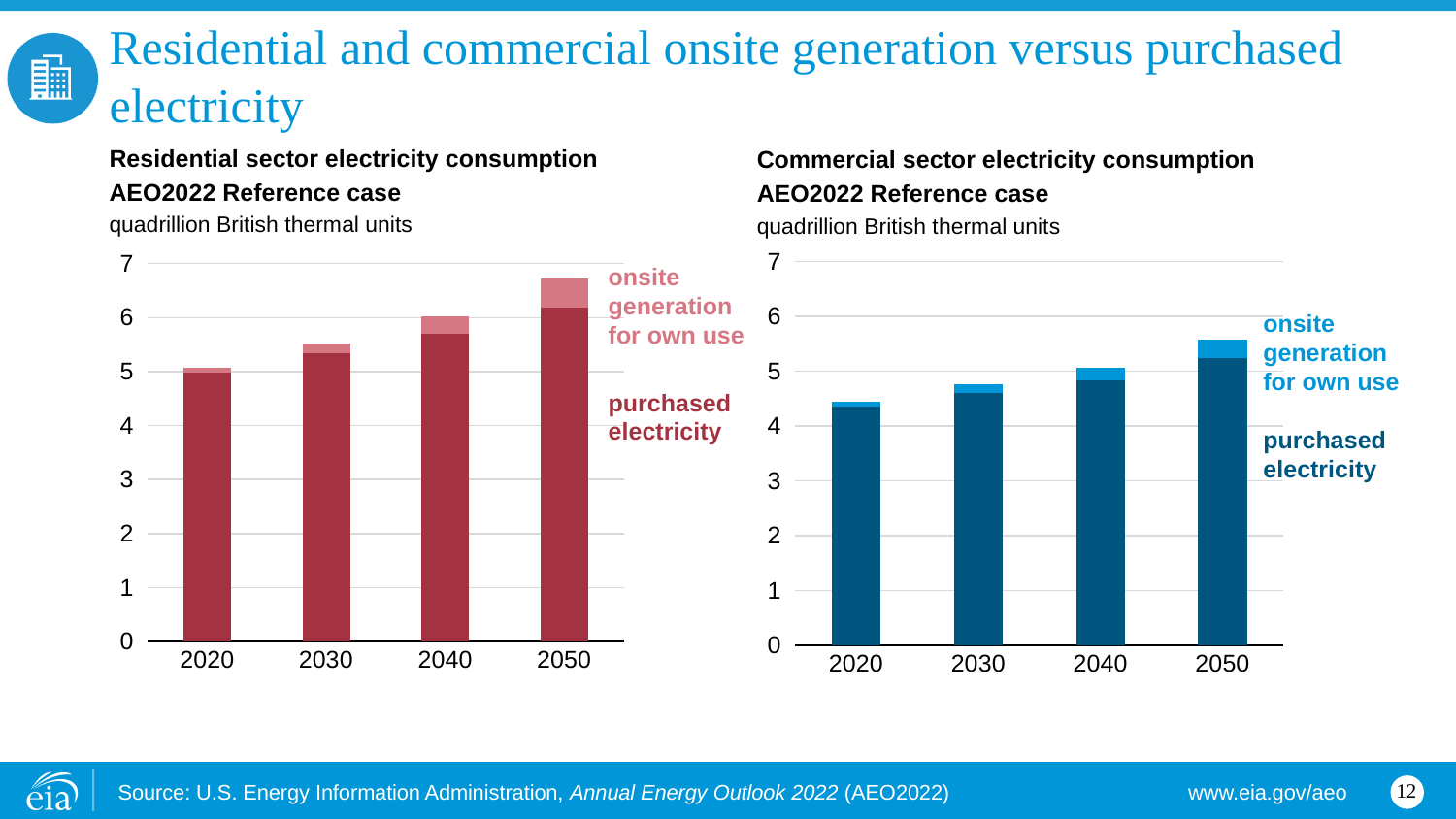
What unit is used on the y axis of the Residential sector electricity consumption chart? quadrillion British thermal units In the Residential sector electricity consumption chart, is the total value for 2050 greater or less than 6? greater How many series are labelled in the Residential sector electricity consumption chart? 2 In the Commercial sector electricity consumption chart, do the total bars rise or fall from 2020 to 2050? rise In the Commercial sector electricity consumption chart, which year has the lowest total bar? 2020 In the Commercial sector electricity consumption chart, is the total value for 2030 greater or less than 5? less In the Residential sector electricity consumption chart, which year has the highest total bar? 2050 In the Residential sector electricity consumption chart, is the total value for 2030 greater or less than 6? less What kind of chart is the Residential sector electricity consumption chart? bar chart Which is larger in 2050: the total bar in the Residential sector chart or the total bar in the Commercial sector chart? Residential sector How many years are shown on the x axis of the Commercial sector electricity consumption chart? 4